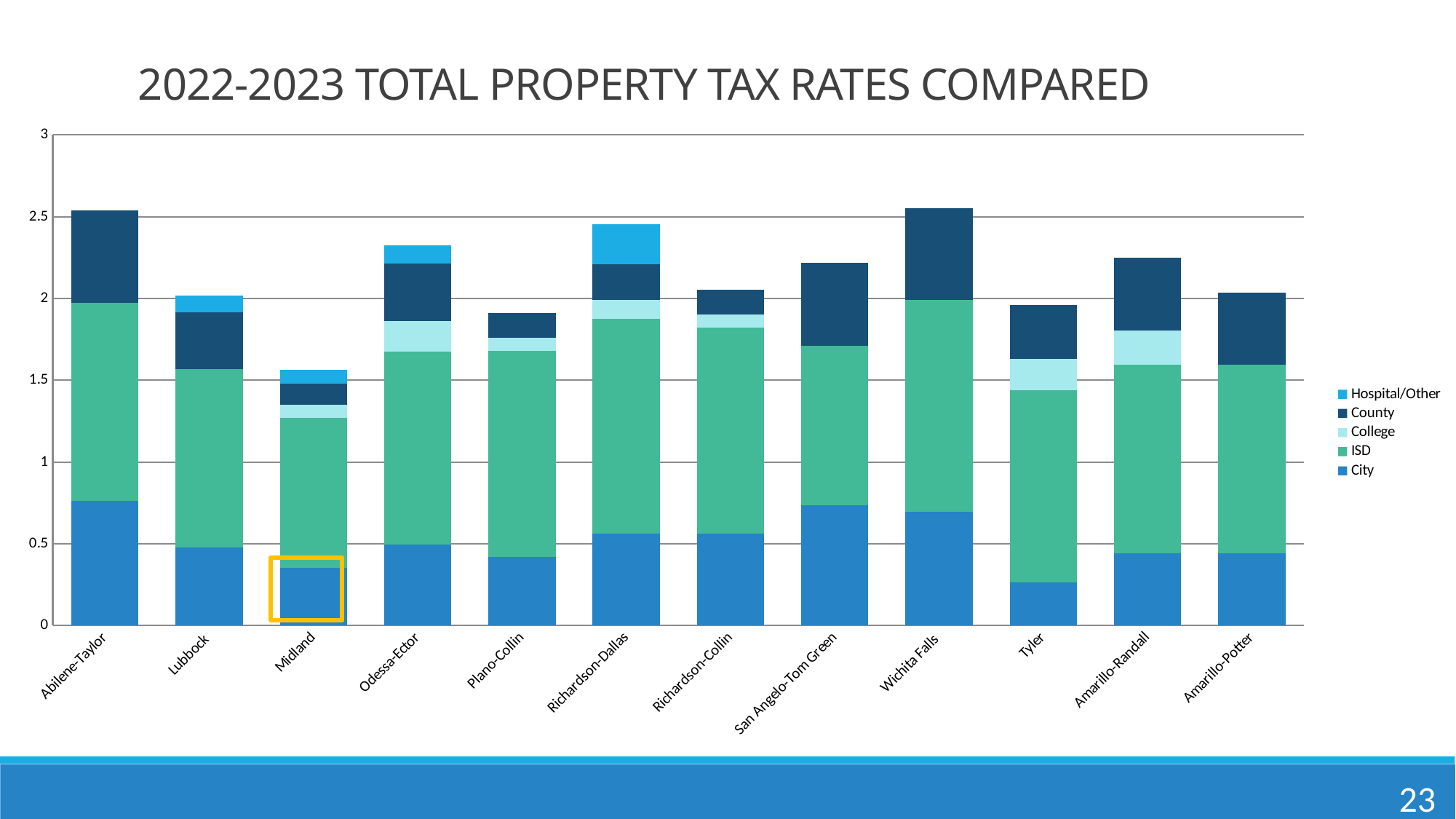
Which category has the lowest total property tax rate? Midland Is the total value for Richardson-Dallas greater or less than 2? greater What kind of chart is shown on the slide? Stacked bar chart What is the title of the chart? 2022-2023 TOTAL PROPERTY TAX RATES COMPARED Which category has the lowest City segment? Tyler Which has the larger total property tax rate, Midland or Odessa-Ector? Odessa-Ector Is the total value for Midland greater or less than 2? less Is the City segment for Tyler greater or less than 0.5? less Which series is listed first in the legend? Hospital/Other How many cities/categories are shown along the x axis? 12 How many series does the legend list? 5